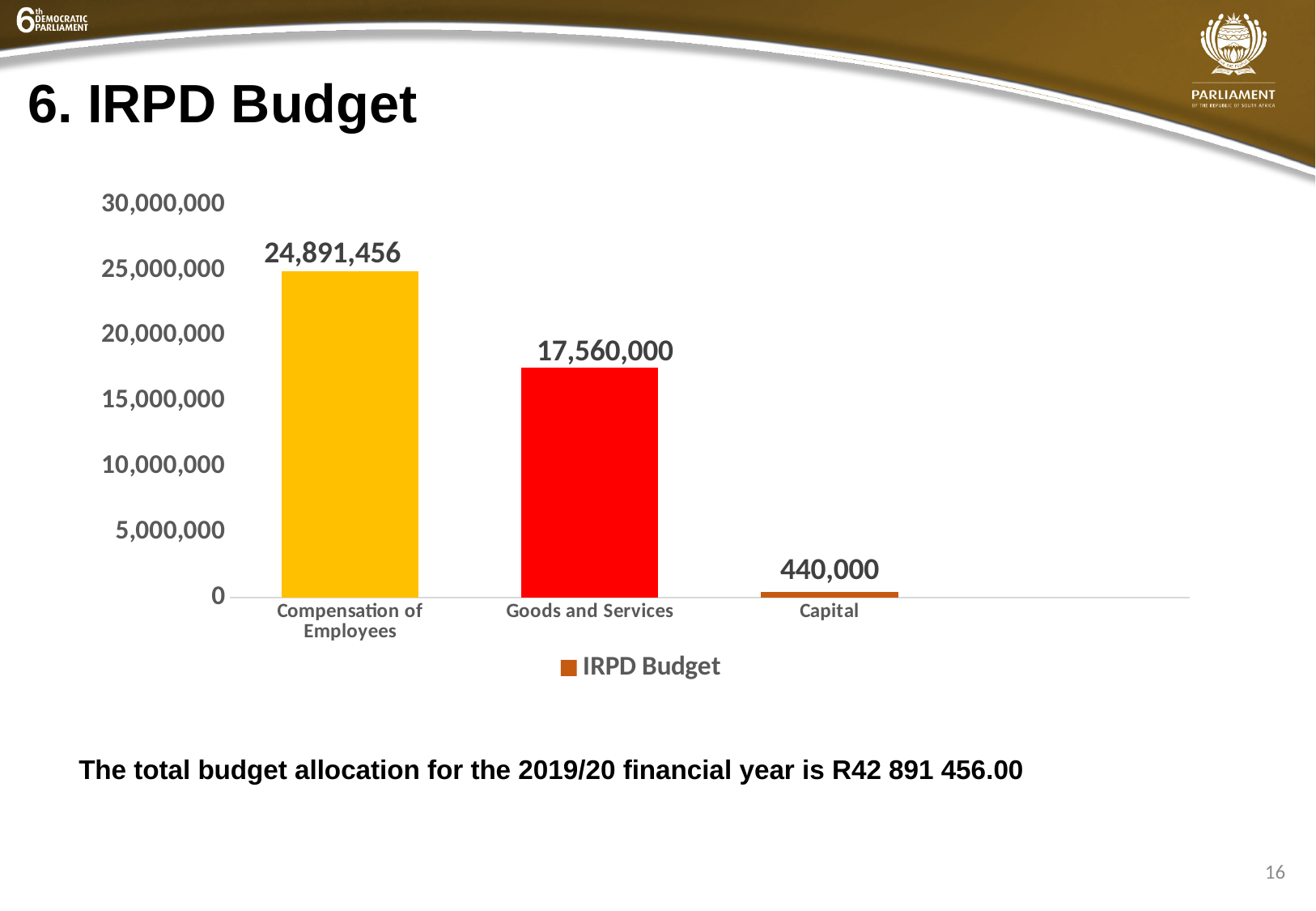
Is the value for Goods and Services greater or less than 20,000,000? less Which is larger, the value for Goods and Services or the value for Capital? Goods and Services What kind of chart is shown on the slide? bar chart Which category has the highest IRPD Budget value? Compensation of Employees What series name does the chart legend show? IRPD Budget How many categories are shown on the x axis of the chart? 3 What is the difference between the Compensation of Employees and Goods and Services values? 7,331,456 Which category has the lowest IRPD Budget value? Capital What is the difference between the Goods and Services and Capital values? 17,120,000 What is the IRPD Budget value for Capital? 440,000 What is the IRPD Budget value for Goods and Services? 17,560,000 What is the IRPD Budget value for Compensation of Employees? 24,891,456